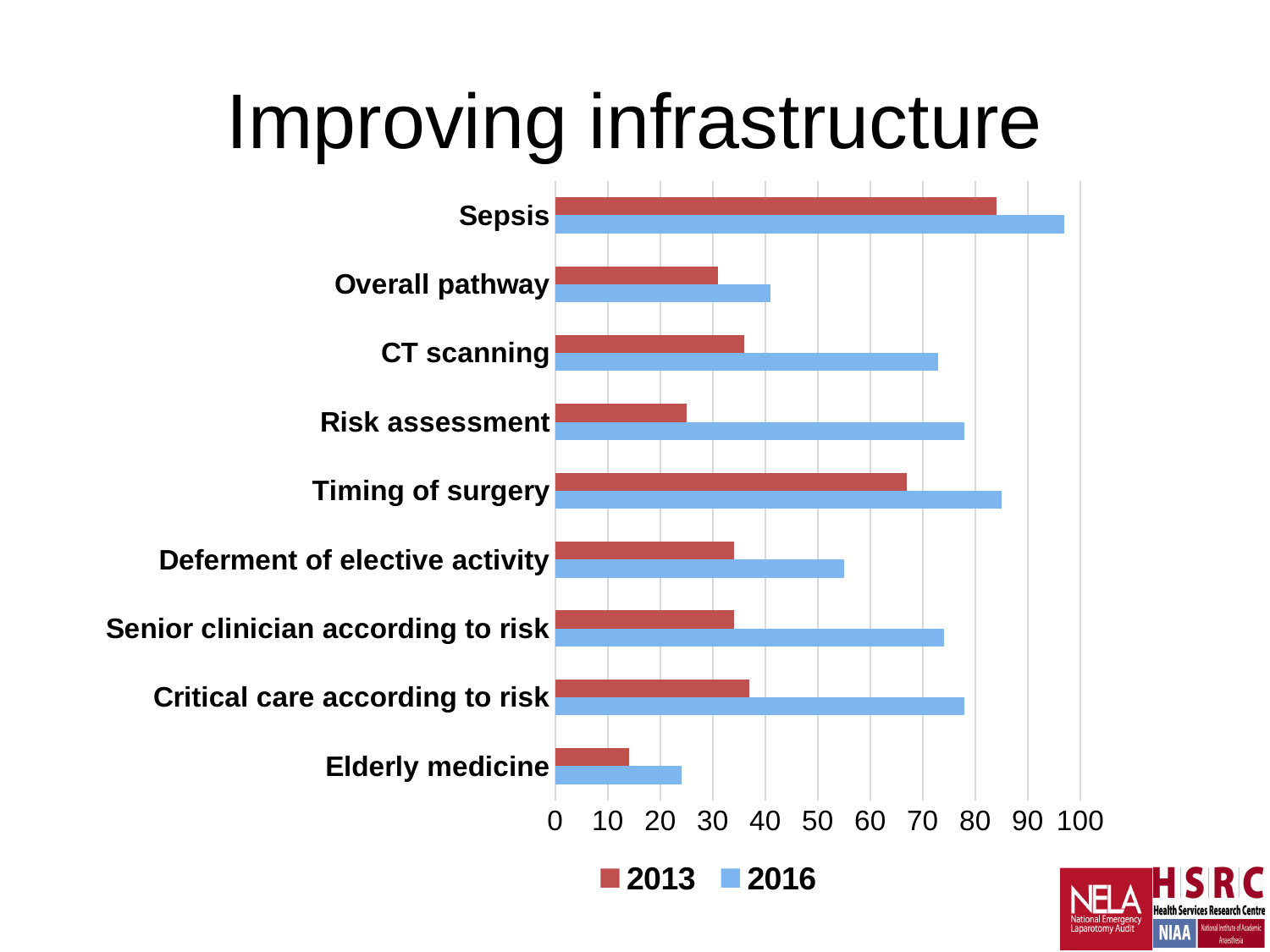
What kind of chart is shown on the slide? bar chart Is the 2016 value for CT scanning greater or less than 70? greater How many categories are shown on the chart? 9 What are the two series listed in the legend? 2013 and 2016 Which has the larger 2016 value, Risk assessment or Overall pathway? Risk assessment Is the 2016 value for Overall pathway greater or less than 50? less Is the 2016 value for Sepsis greater or less than 90? greater Which category has the lowest value for 2016? Elderly medicine How many series does the legend list? 2 Which category has the lowest value for 2013? Elderly medicine Which category has the highest value for 2016? Sepsis